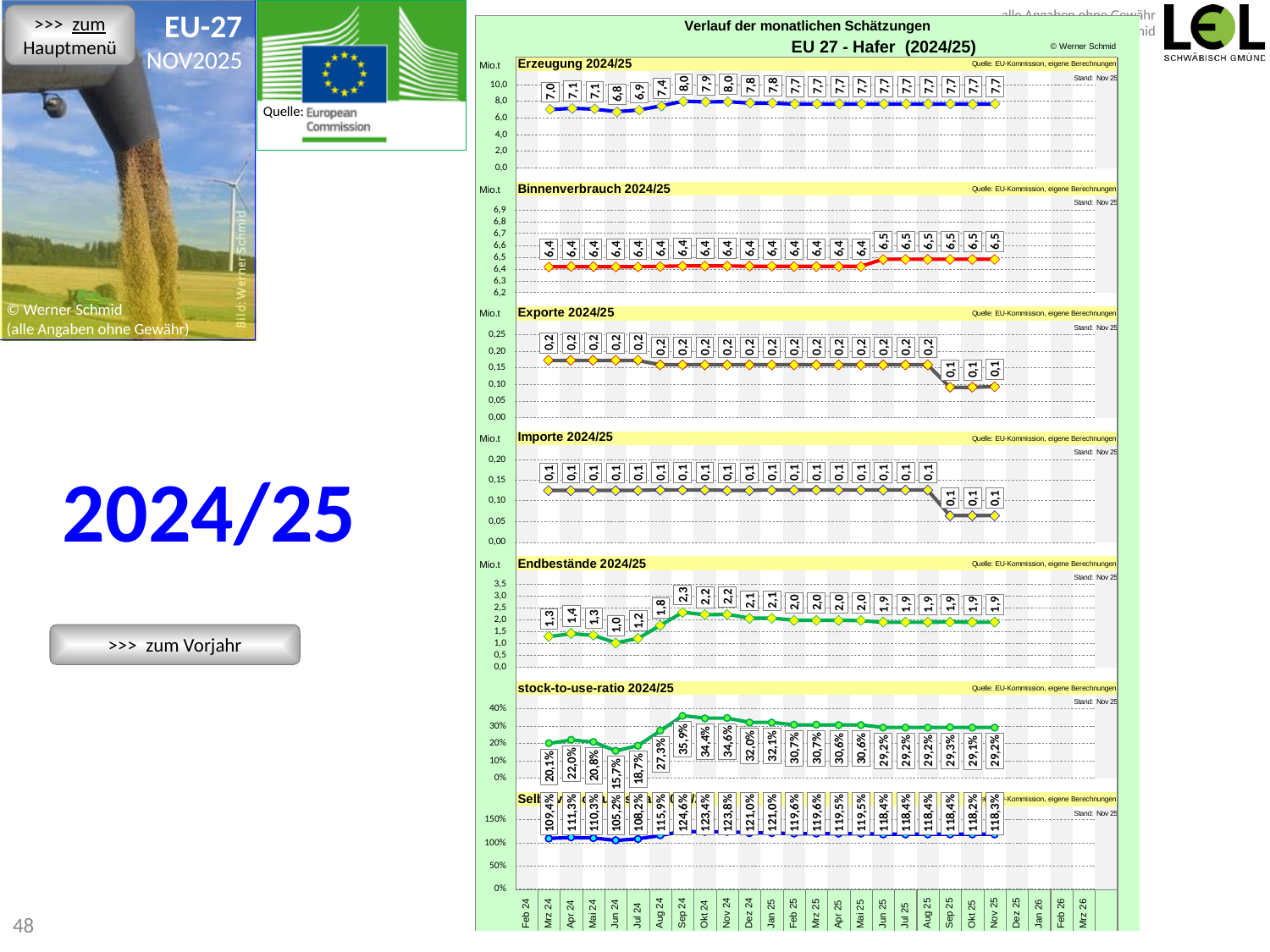
In the 'Erzeugung 2024/25' chart, what is the difference between the highest value (8,0) and the lowest value (6,8)? 1,2 In the 'stock-to-use-ratio 2024/25' chart, what is the highest value shown? 35,9% What is the overall title of the chart panel on the right side of the slide? Verlauf der monatlichen Schätzungen EU 27 - Hafer (2024/25) In the 'Endbestände 2024/25' chart, what is the lowest value shown? 1,0 In the 'Erzeugung 2024/25' chart, what is the lowest value shown? 6,8 In the 'Erzeugung 2024/25' chart, what is the highest value shown? 8,0 In the 'Binnenverbrauch 2024/25' chart, what is the value of the last (most recent) data point? 6,5 What kind of chart is the 'Erzeugung 2024/25' chart? line chart How many data points are plotted in the 'Erzeugung 2024/25' chart? 21 In the 'Endbestände 2024/25' chart, what is the highest value shown? 2,3 In the 'stock-to-use-ratio 2024/25' chart, what is the lowest value shown? 15,7% In the 'Exporte 2024/25' chart, do the values rise or fall toward the end of the series? fall